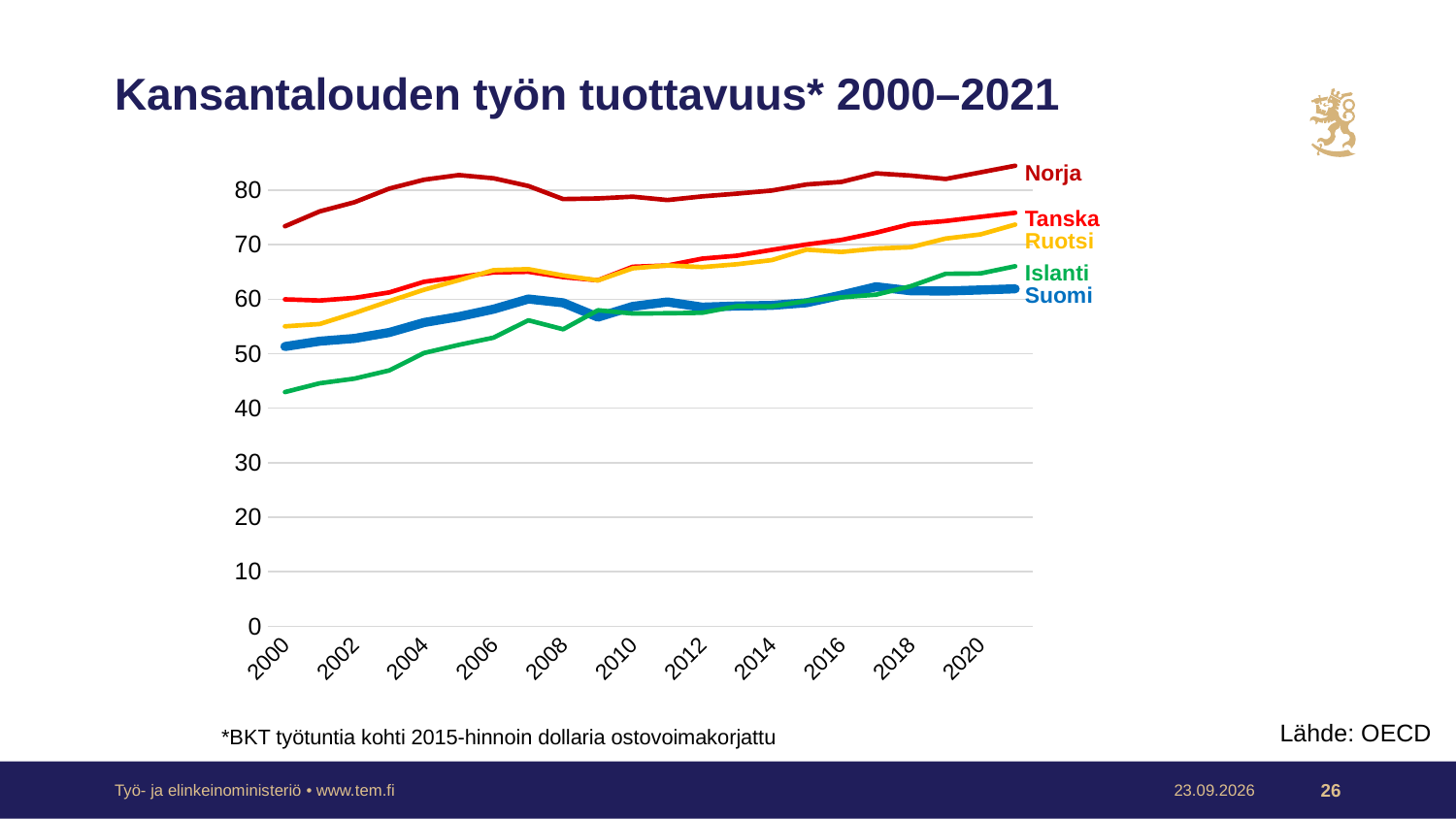
How many countries (series) are plotted on the chart? 5 Is the value for Islanti in 2000 greater or less than 50? less Which country has the highest labour productivity line throughout the period? Norja Is the value for Suomi in 2020 greater or less than 70? less In 2020, which is larger: the value for Norja or the value for Suomi? Norja What kind of chart is shown on the slide? line chart Which country has the lowest value in 2000? Islanti Is the value for Norja in 2020 greater or less than 80? greater In 2000, which is larger: the value for Tanska or the value for Ruotsi? Tanska Does the line for Islanti rise or fall overall from 2000 to 2021? rise What is the title of the chart? Kansantalouden työn tuottavuus* 2000–2021